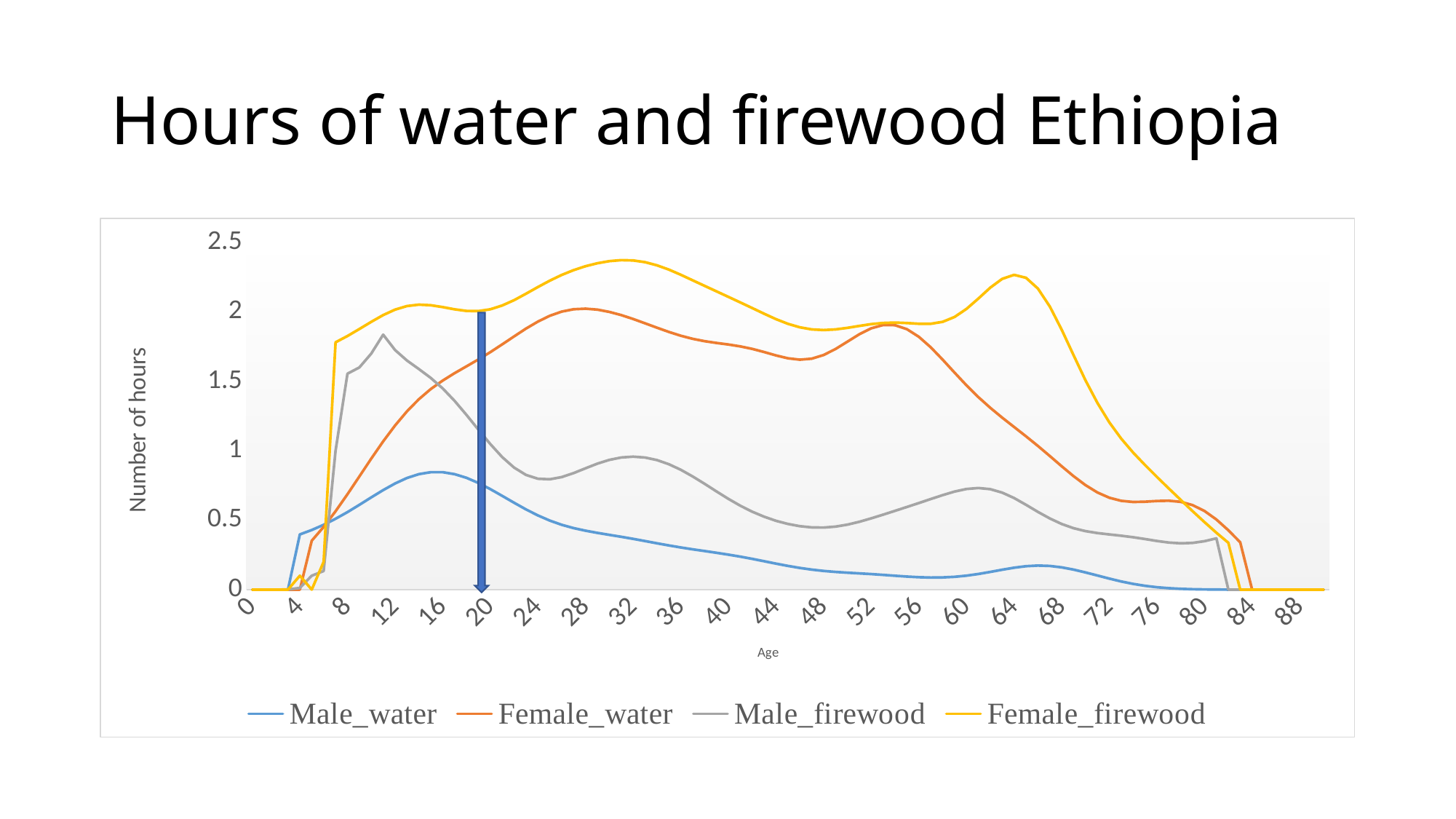
Is the value for Male_firewood at age 48 greater or less than 0.5? less Is the value for Male_water at age 16 greater or less than 1? less What kind of chart is shown on the slide? line chart At age 40, which is larger: Female_water or Male_water? Female_water What is the title of the chart on the slide? Hours of water and firewood Ethiopia Does the Female_water line rise or fall between age 56 and age 84? fall What is the label on the vertical axis of the chart? Number of hours At age 64, which is larger: Female_firewood or Female_water? Female_firewood Which series reaches the highest value anywhere on the chart? Female_firewood Is the value for Female_firewood at age 32 greater or less than 2? greater How many series does the legend list? 4